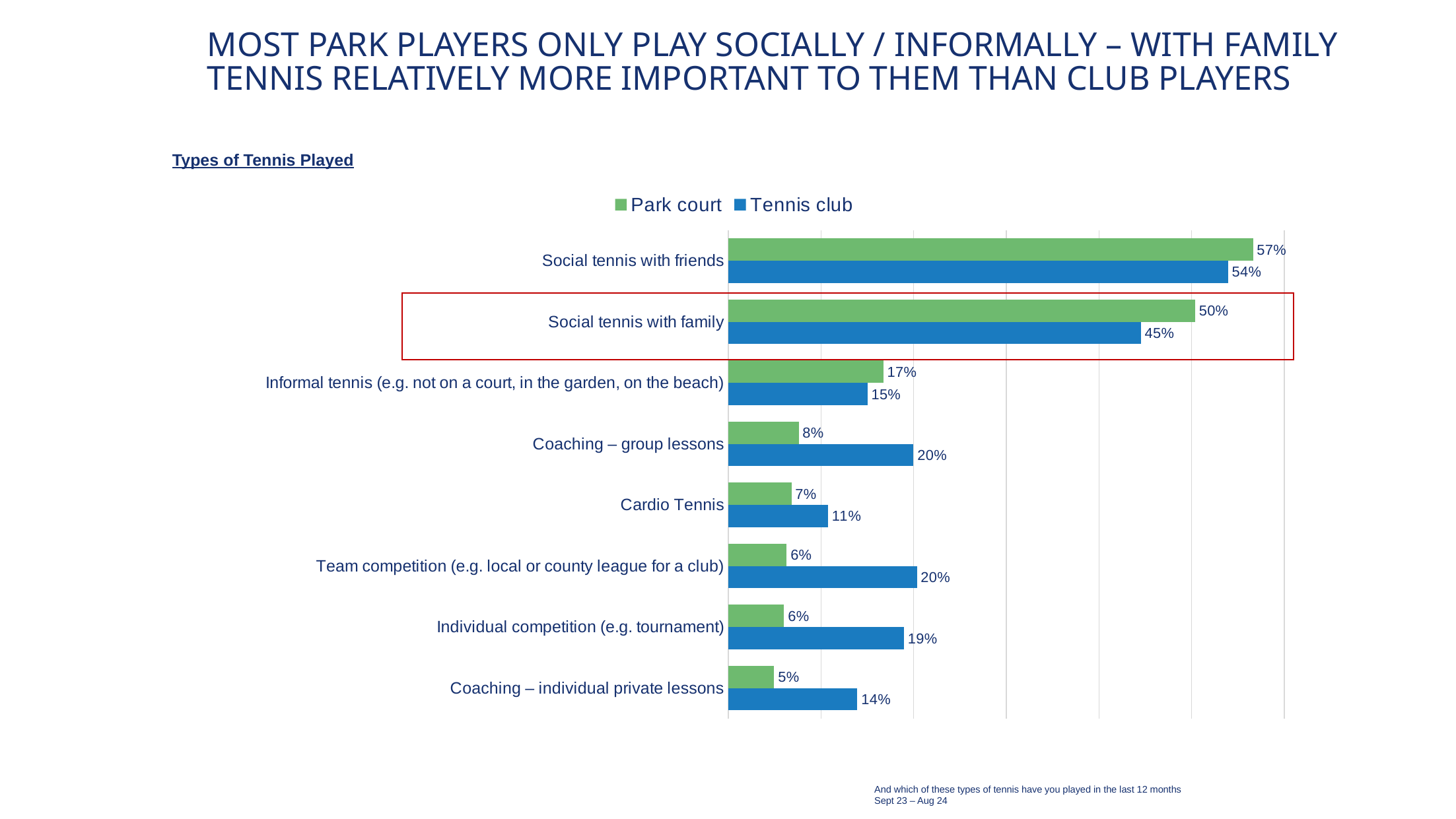
For Individual competition (e.g. tournament), which is larger: the Park court value or the Tennis club value? Tennis club What is the Park court value for Cardio Tennis? 7% What is the difference between the Park court and Tennis club values for Social tennis with family? 5% What is the difference between the Tennis club and Park court values for Team competition (e.g. local or county league for a club)? 14% What is the Park court value for Social tennis with family? 50% Which category has the highest Park court value? Social tennis with friends How many categories are shown on the chart? 8 How many series does the legend list? 2 What is the Tennis club value for Coaching – individual private lessons? 14% Which category has the lowest Park court value? Coaching – individual private lessons What is the Tennis club value for Coaching – group lessons? 20% Which category has the lowest Tennis club value? Cardio Tennis